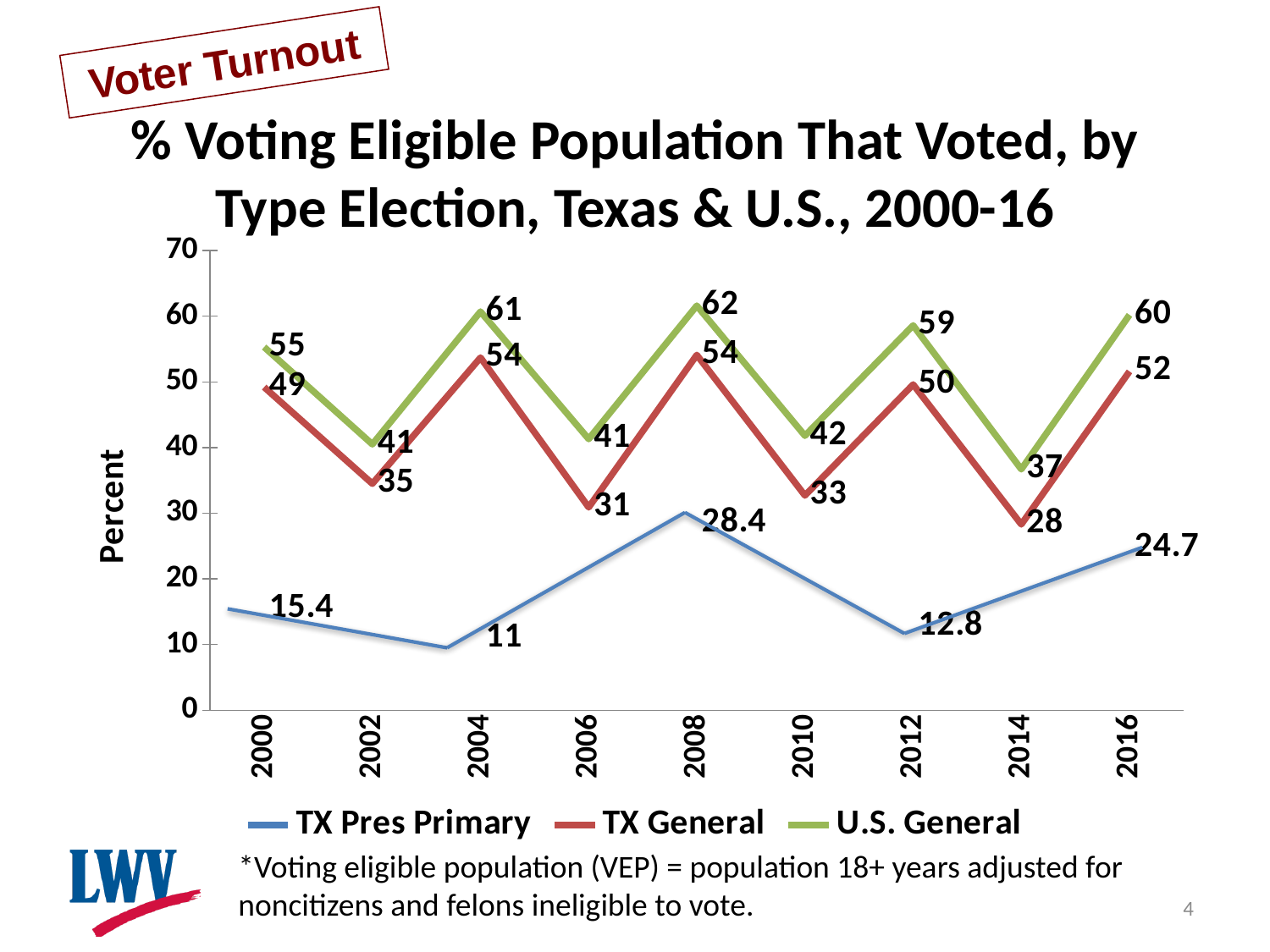
In which year was the TX General turnout lowest? 2014 What is the difference between the U.S. General and TX General turnout in 2016? 8 How many years are shown on the x axis? 9 Which was higher in 2012: the TX General turnout or the TX Pres Primary turnout? TX General What was the U.S. General turnout in 2008? 62 What was the TX General turnout in 2014? 28 Did the TX Pres Primary turnout rise or fall from 2012 to 2016? rise What was the TX Pres Primary turnout in 2016? 24.7 How many series does the legend list? 3 In which year was the TX Pres Primary turnout highest? 2008 What is the label on the y axis? Percent What type of chart is shown on the slide? line chart